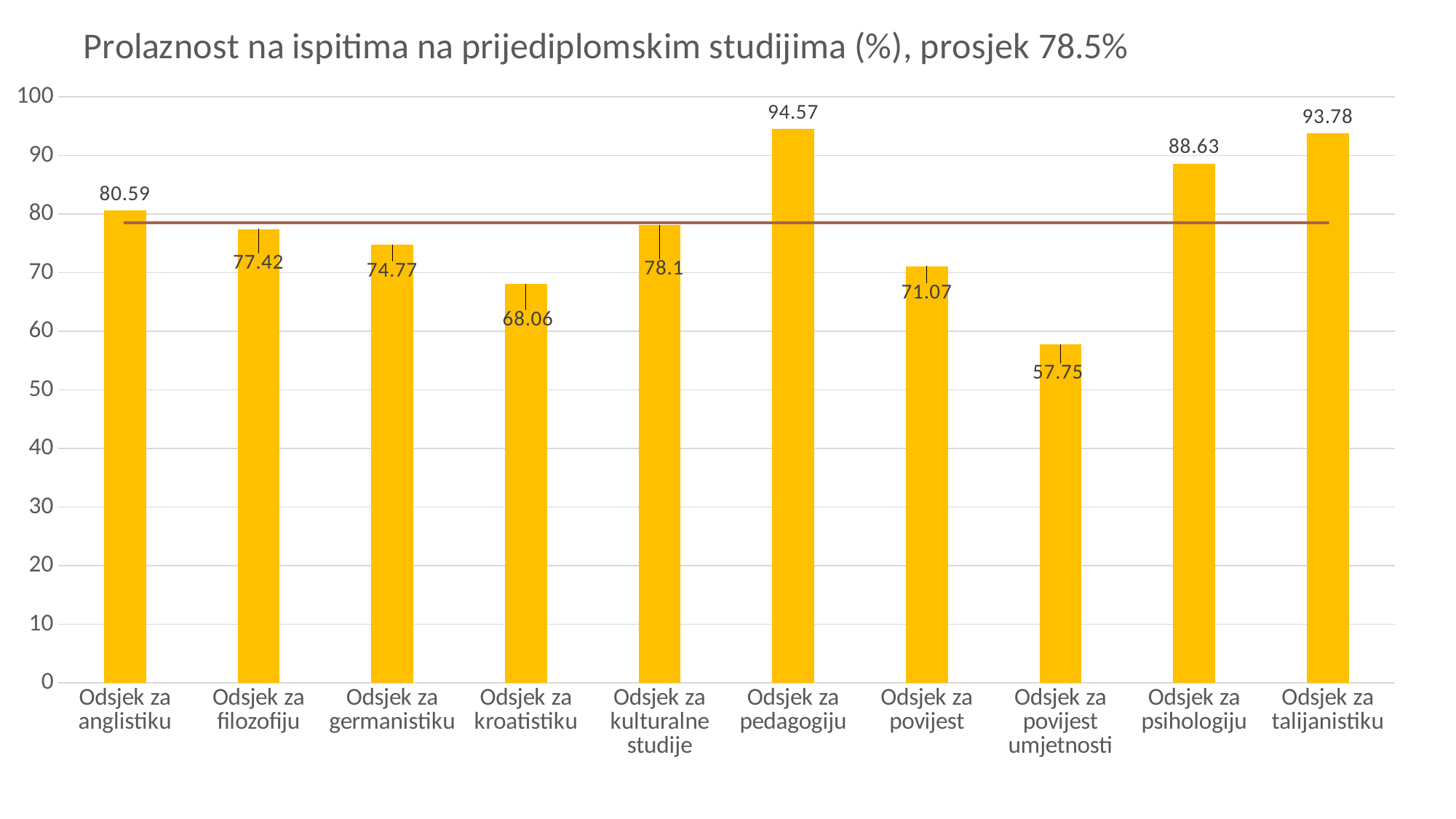
What is the value for Odsjek za anglistiku? 80.59 Is the value for Odsjek za povijest greater or less than 80? less Which is larger, the value for Odsjek za filozofiju or the value for Odsjek za germanistiku? Odsjek za filozofiju What is the title of the chart? Prolaznost na ispitima na prijediplomskim studijima (%), prosjek 78.5% Which department has the highest value? Odsjek za pedagogiju How many departments are shown on the chart? 10 What is the difference between the values for Odsjek za pedagogiju and Odsjek za talijanistiku? 0.79 What kind of chart is this? bar chart What is the difference between the values for Odsjek za psihologiju and Odsjek za kroatistiku? 20.57 What is the value for Odsjek za povijest umjetnosti? 57.75 What is the value for Odsjek za kulturalne studije? 78.1 Which department has the lowest value? Odsjek za povijest umjetnosti